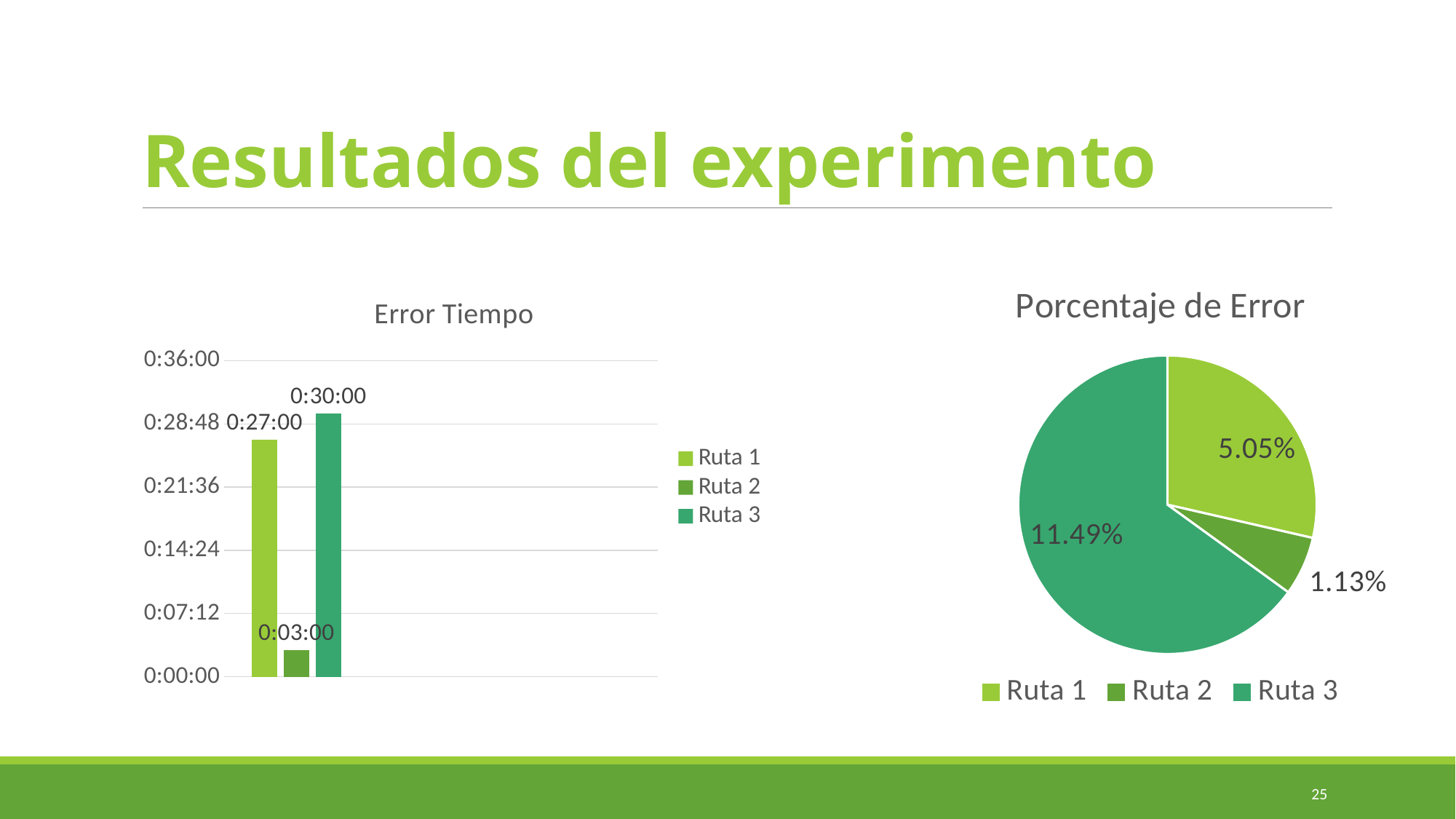
In the 'Porcentaje de Error' chart, what is the value for Ruta 2? 1.13% In the 'Error Tiempo' chart, what is the value for Ruta 2? 0:03:00 In the 'Porcentaje de Error' chart, which is larger, the value for Ruta 1 or Ruta 2? Ruta 1 In the 'Error Tiempo' chart, how many series does the legend list? 3 In the 'Error Tiempo' chart, which series has the lowest value? Ruta 2 In the 'Porcentaje de Error' chart, what is the value for Ruta 3? 11.49% In the 'Error Tiempo' chart, what is the difference between the values for Ruta 3 and Ruta 1? 0:03:00 In the 'Porcentaje de Error' chart, which slice is the largest? Ruta 3 What kind of chart is 'Porcentaje de Error'? Pie chart In the 'Error Tiempo' chart, which series has the highest value? Ruta 3 What kind of chart is 'Error Tiempo'? Bar chart In the 'Error Tiempo' chart, what is the value for Ruta 1? 0:27:00